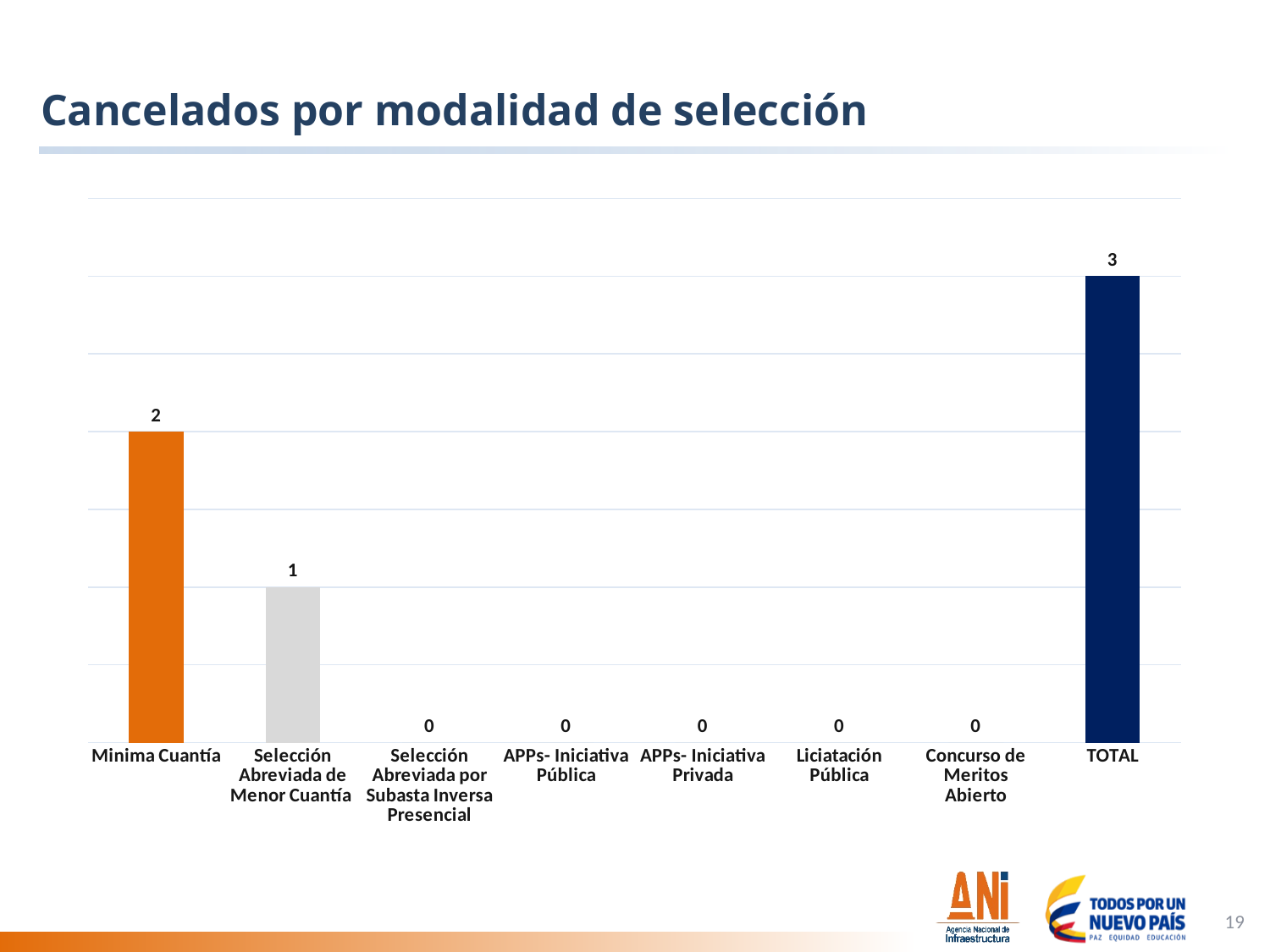
What is the difference between the values for Minima Cuantía and Selección Abreviada de Menor Cuantía? 1 What is the value for Selección Abreviada de Menor Cuantía? 1 How many categories have a value of 0? 5 Excluding TOTAL, which selection modality has the highest value? Minima Cuantía What is the title of the slide? Cancelados por modalidad de selección What is the value for Minima Cuantía? 2 Which category has the highest value? TOTAL How many categories are shown on the x axis? 8 What kind of chart is shown on the slide? Bar chart What is the value for Licitación Pública? 0 What is the value for TOTAL? 3 Which is larger, the value for Minima Cuantía or the value for Selección Abreviada de Menor Cuantía? Minima Cuantía